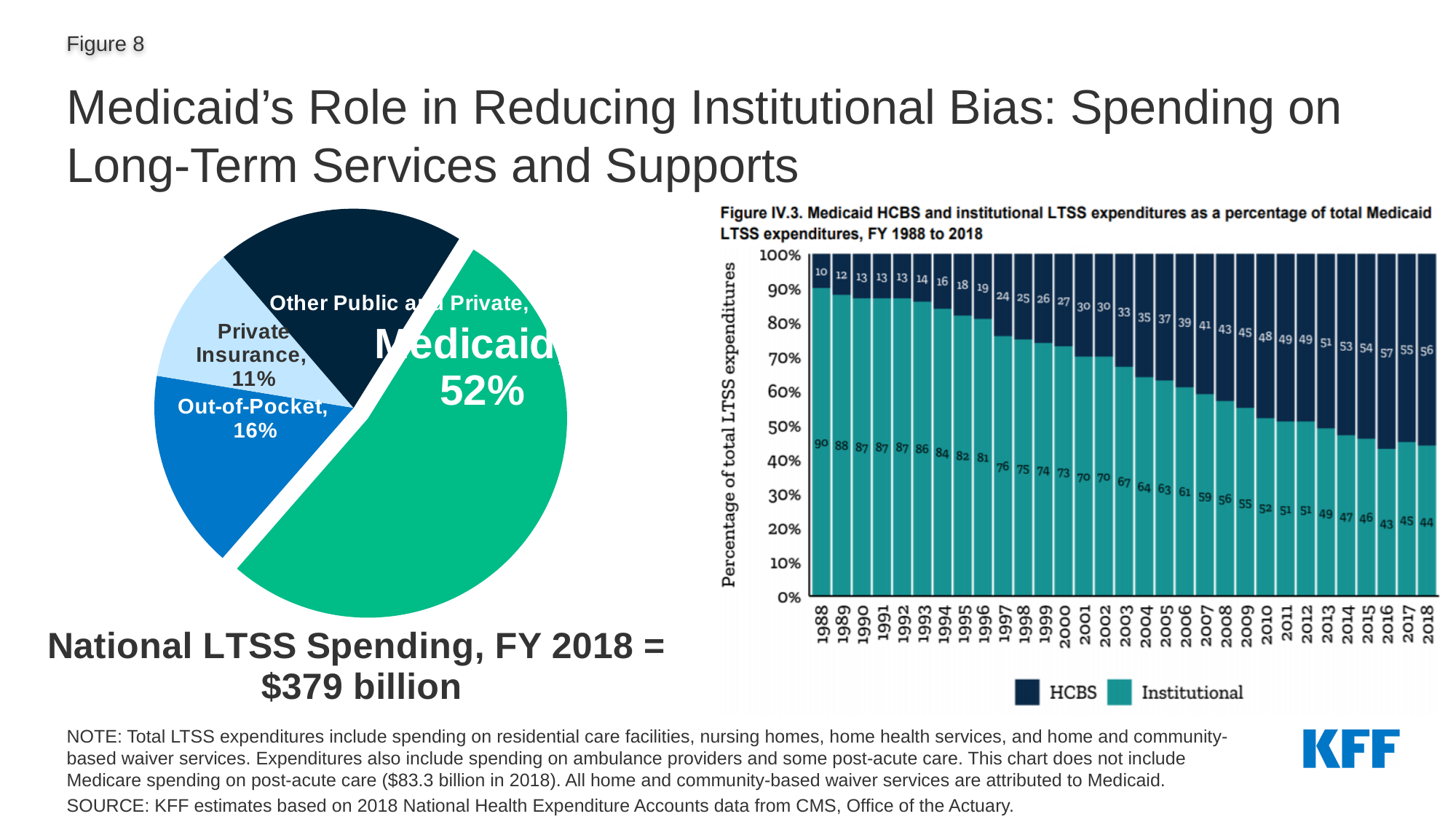
In the pie chart on the left, what total national LTSS spending figure for FY 2018 is stated below the chart? $379 billion In the stacked bar chart on the right (Figure IV.3), in which year is the HCBS share highest? 2016 In the stacked bar chart on the right (Figure IV.3), in which year is the Institutional share lowest? 2016 In the stacked bar chart on the right (Figure IV.3), how many series does the legend list? 2 In the stacked bar chart on the right (Figure IV.3), what is the difference in percentage points between the HCBS share in 2018 and the HCBS share in 1988? 46 percentage points In the stacked bar chart on the right (Figure IV.3), what percentage of Medicaid LTSS expenditures went to Institutional care in 2018? 44 In the pie chart on the left, what is the difference in percentage points between the Medicaid share and the Private Insurance share? 41 percentage points In the stacked bar chart on the right (Figure IV.3), what percentage of Medicaid LTSS expenditures went to HCBS in 1988? 10 In the pie chart on the left, which is larger: the Out-of-Pocket share or the Private Insurance share? Out-of-Pocket In the stacked bar chart on the right (Figure IV.3), how does the Institutional share change from 1988 to 2018? It falls In the pie chart on the left, what share of national LTSS spending in FY 2018 is attributed to Medicaid? 52% In the pie chart on the left, what is the Out-of-Pocket share of national LTSS spending? 16%